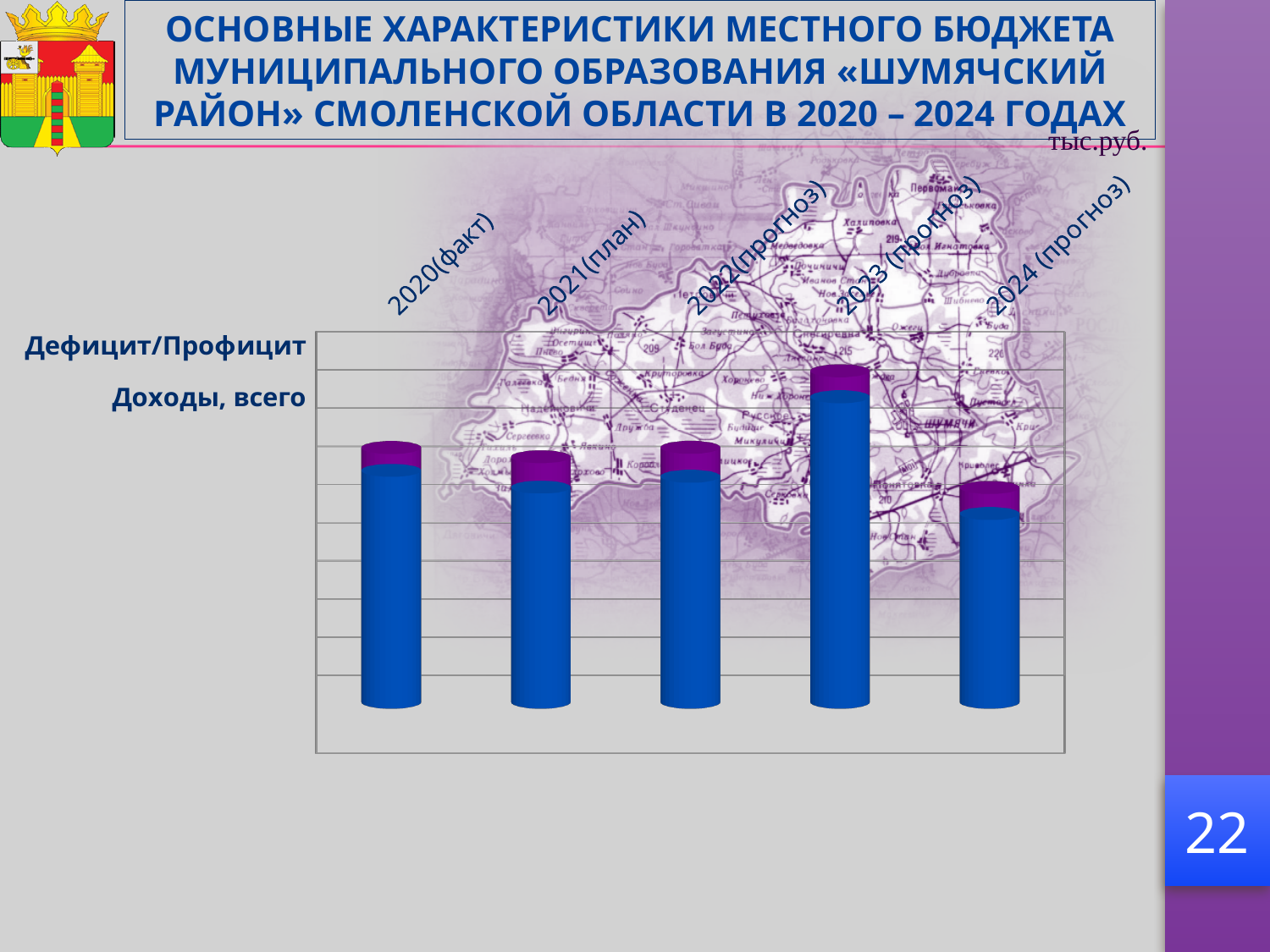
Which year has the shortest bar on the chart? 2024 (прогноз) What unit of measurement is indicated for the chart values? тыс.руб. Which bar is taller: 2023 (прогноз) or 2024 (прогноз)? 2023 (прогноз) How many categories (years) are plotted on the chart? 5 Do the bar heights rise steadily from 2020(факт) to 2024 (прогноз)? No Which bar is taller: 2020(факт) or 2023 (прогноз)? 2023 (прогноз) What kind of chart is shown on the slide? bar chart Which bar is taller: 2021(план) or 2024 (прогноз)? 2021(план) Which year has the tallest bar on the chart? 2023 (прогноз)